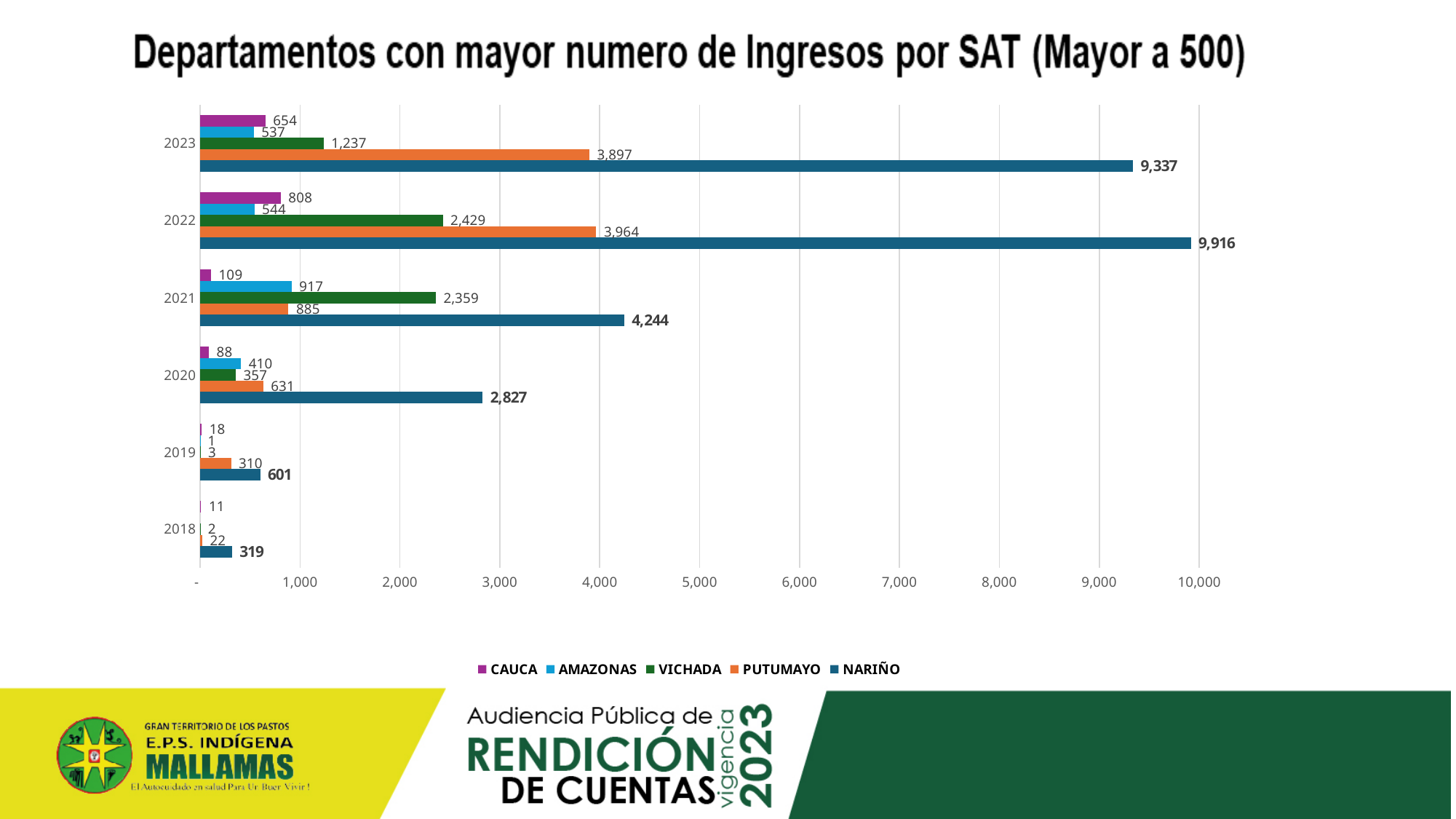
Which department has the lowest value in 2020? CAUCA Is the value for NARIÑO in 2021 greater or less than 4,000? greater How many series does the legend list? 5 Which year has the larger VICHADA value, 2022 or 2021? 2022 What is the value for AMAZONAS in 2021? 917 How many years are shown on the chart? 6 What is the difference between the NARIÑO values for 2022 and 2023? 579 What kind of chart is shown on the slide? bar chart Which department has the highest value in 2021? NARIÑO What is the value for NARIÑO in 2022? 9,916 Do the NARIÑO values rise or fall from 2018 to 2022? rise What is the value for PUTUMAYO in 2023? 3,897